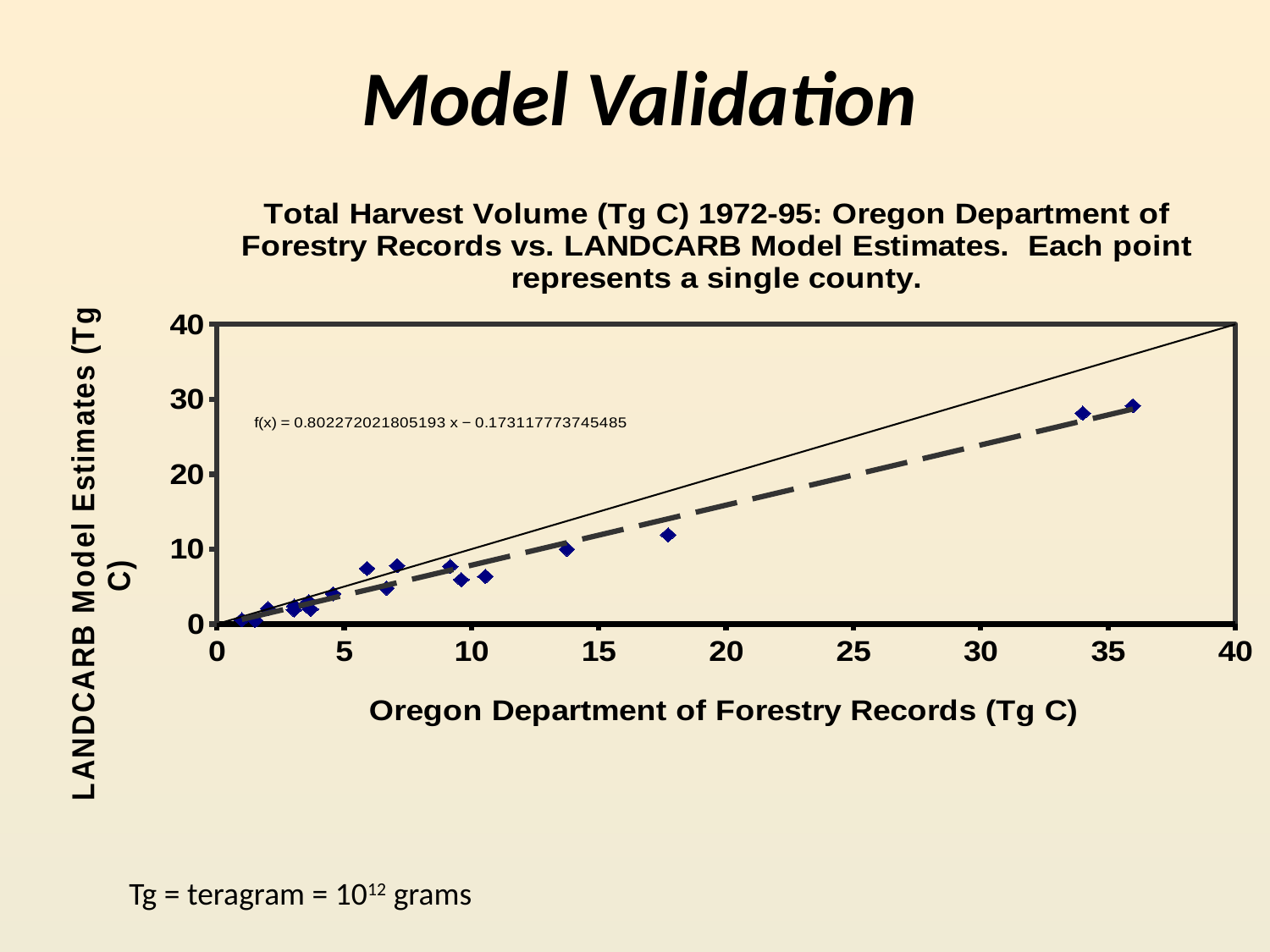
What is the highest value shown on the y axis? 40 Does the point with the highest x value have a LANDCARB estimate greater or less than 20? greater Is the LANDCARB model estimate for the point at roughly 34 Tg C on the x axis greater or less than 30? less Is the LANDCARB model estimate for the point at roughly 9.5 Tg C on the x axis greater or less than 10? less What is the slope of the fitted trendline equation printed on the chart? 0.802272021805193 Do the plotted points lie above or below the thin 1:1 diagonal line? below Do the LANDCARB model estimates rise or fall as the Oregon Department of Forestry Records values increase along the x axis? rise What is the title of the x axis? Oregon Department of Forestry Records (Tg C) What is the highest value shown on the x axis? 40 What is the title of the y axis? LANDCARB Model Estimates (Tg C) What kind of chart is shown on the slide? scatter chart